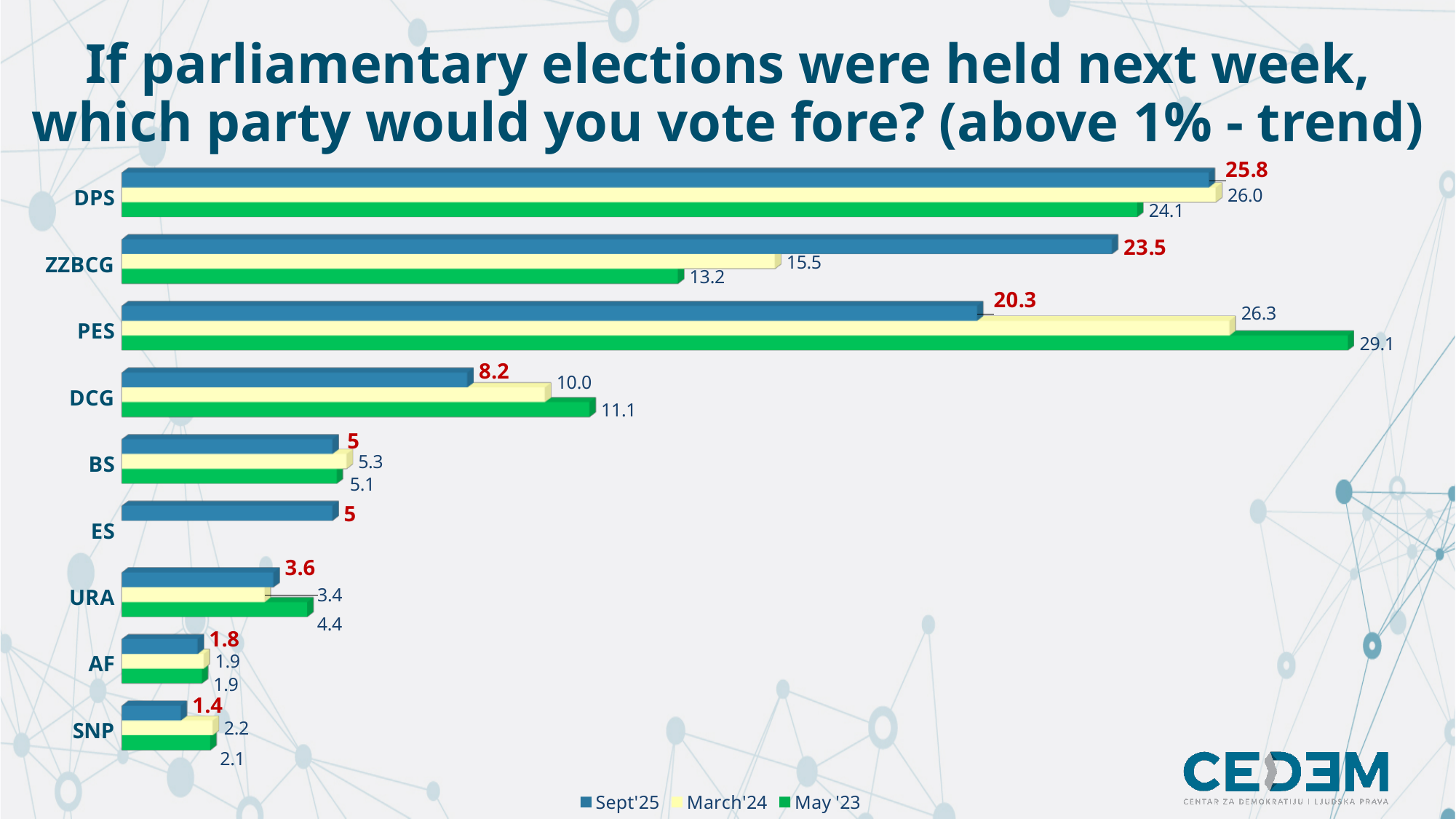
What is the May '23 value for PES? 29.1 What kind of chart is shown on the slide? Bar chart Which series is shown in green in the legend? May '23 What is the Sept'25 value for ZZBCG? 23.5 How many series does the legend list? 3 Which party has the highest Sept'25 value? DPS Which party has the lowest Sept'25 value? SNP What is the difference between the May '23 and Sept'25 values for PES? 8.8 What is the difference between the Sept'25 and May '23 values for ZZBCG? 10.3 Which is larger for ZZBCG: the Sept'25 value or the March'24 value? Sept'25 How many parties are shown on the chart? 9 What is the March'24 value for DCG? 10.0